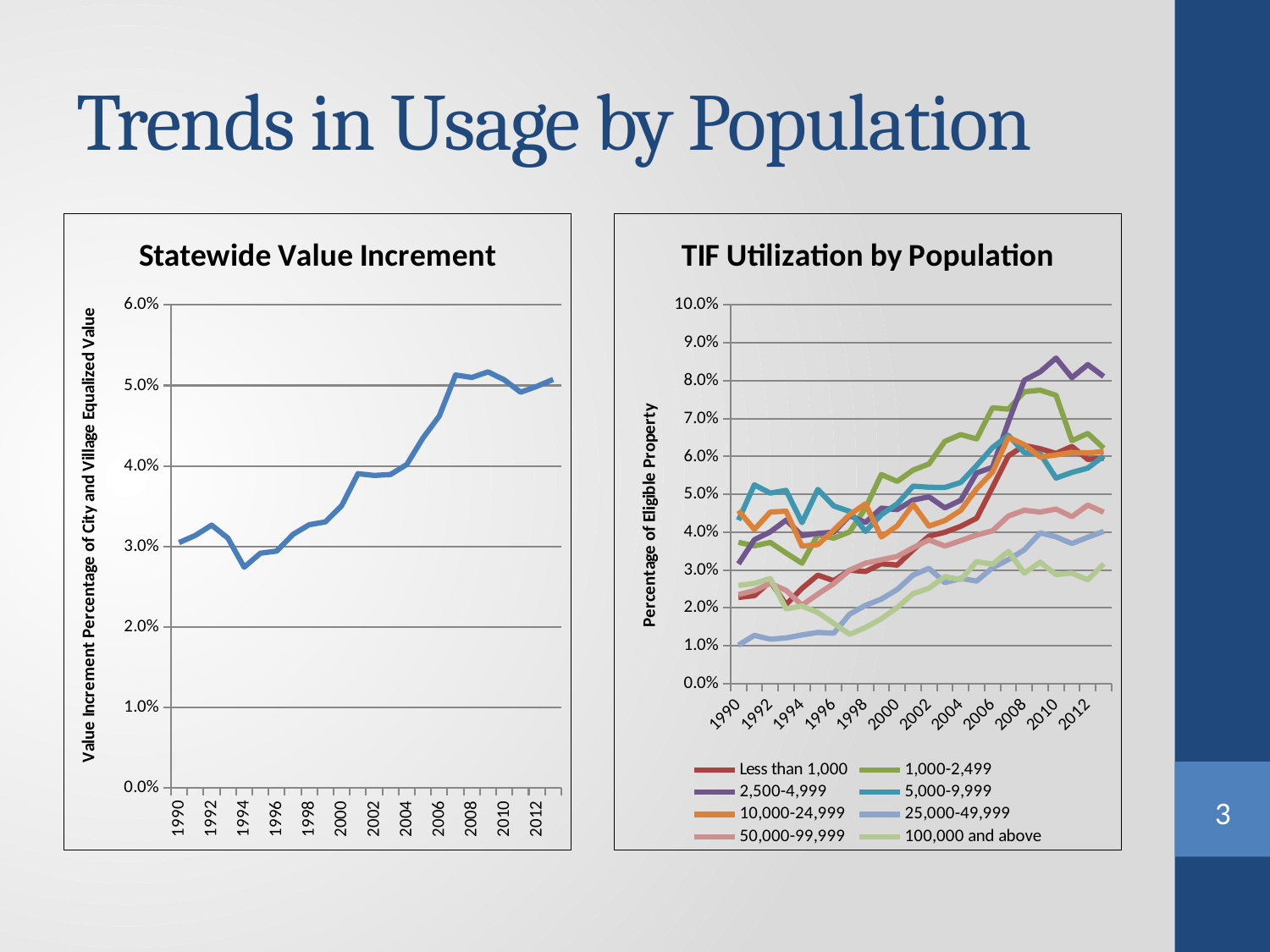
In the Statewide Value Increment chart, do values generally rise or fall from 1994 to 2008? rise In the TIF Utilization by Population chart, is the value for 100,000 and above in 1998 greater or less than 2.0%? less What kind of chart is the Statewide Value Increment chart? line chart In the TIF Utilization by Population chart, which is larger in 2010: 2,500-4,999 or 100,000 and above? 2,500-4,999 What is the y-axis title of the TIF Utilization by Population chart? Percentage of Eligible Property In the TIF Utilization by Population chart, is the value for 2,500-4,999 in 2010 greater or less than 8.0%? greater In the Statewide Value Increment chart, is the value for 1994 greater or less than 3.0%? less What kind of chart is the TIF Utilization by Population chart? line chart How many series does the legend of the TIF Utilization by Population chart list? 8 In the TIF Utilization by Population chart, which population group has the highest value in 2010? 2,500-4,999